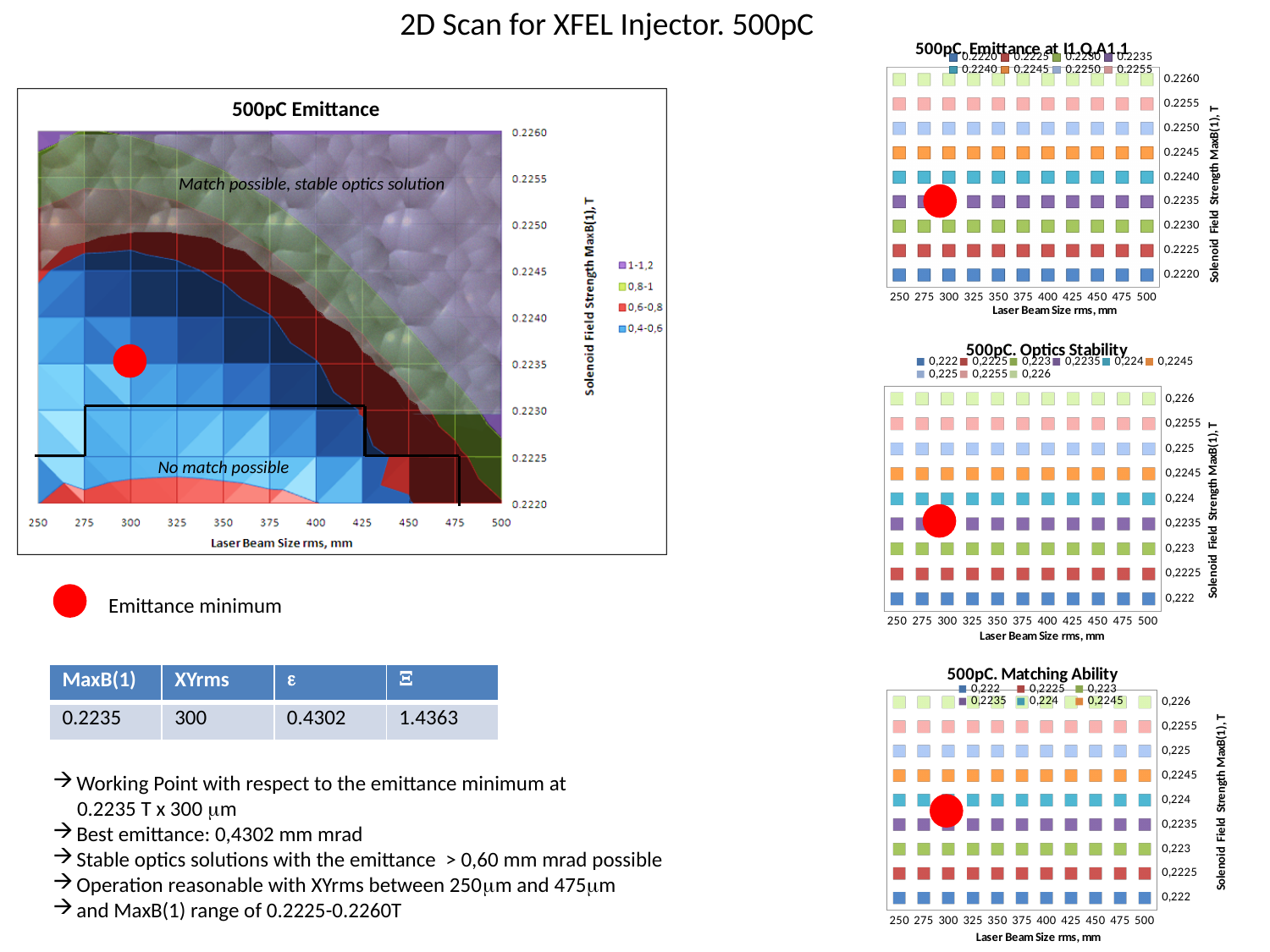
In the '500pC Emittance' chart on the left, at which MaxB(1) value is the red dot marking the emittance minimum located? 0.2235 How many laser beam size tick values are shown on the x axis of the '500pC Emittance' chart on the left? 11 How many entries does the legend of the '500pC Emittance' chart on the left list? 4 What is the lowest laser beam size shown on the x axis of the '500pC. Matching Ability' chart? 250 In the '500pC Emittance' chart on the left, at which laser beam size is the red dot marking the emittance minimum located? 300 What is the highest value shown on the y axis of the '500pC Emittance' chart on the left? 0.2260 What is the first legend entry of the '500pC Emittance' chart on the left? 1-1,2 How many entries does the legend of the '500pC Emittance at I1.Q.A1.1' chart list? 8 What is the x-axis title of the '500pC Emittance' chart on the left? Laser Beam Size rms, mm How many entries does the legend of the '500pC. Matching Ability' chart list? 6 What kind of chart is the large '500pC Emittance' chart on the left of the slide? contour chart